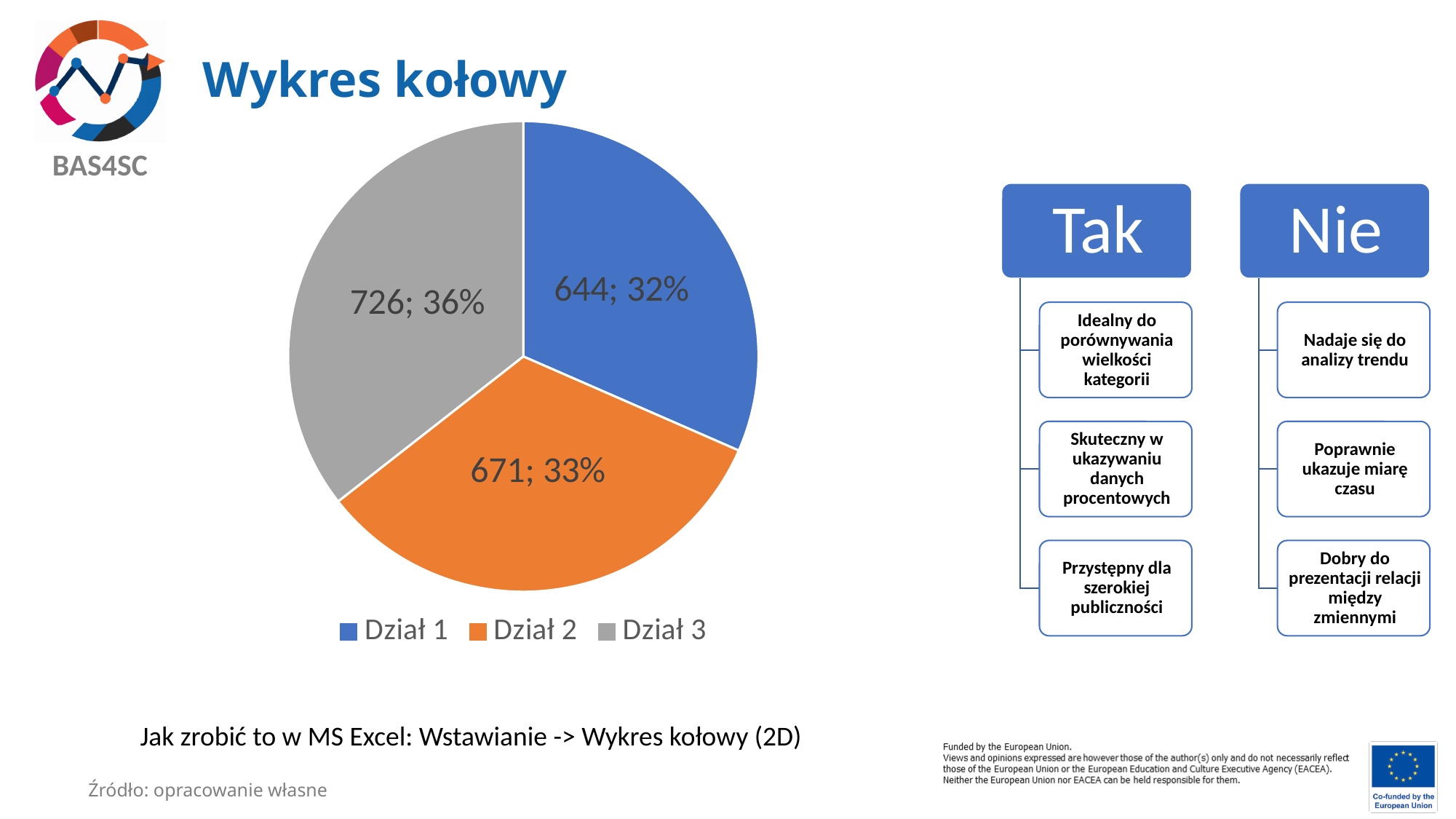
What colour is the slice for Dział 2 in the pie chart? orange Which is larger, the value for Dział 2 or the value for Dział 1? Dział 2 What percentage share does Dział 1 have in the pie chart? 32% What type of chart is shown on the slide? pie chart Which category has the largest slice in the pie chart? Dział 3 What is the value for Dział 1 in the pie chart? 644 What is the difference between the values for Dział 3 and Dział 1? 82 What is the value for Dział 2 in the pie chart? 671 How many categories are shown in the pie chart? 3 Which category has the smallest slice in the pie chart? Dział 1 What percentage share does Dział 3 have in the pie chart? 36% What is the value for Dział 3 in the pie chart? 726